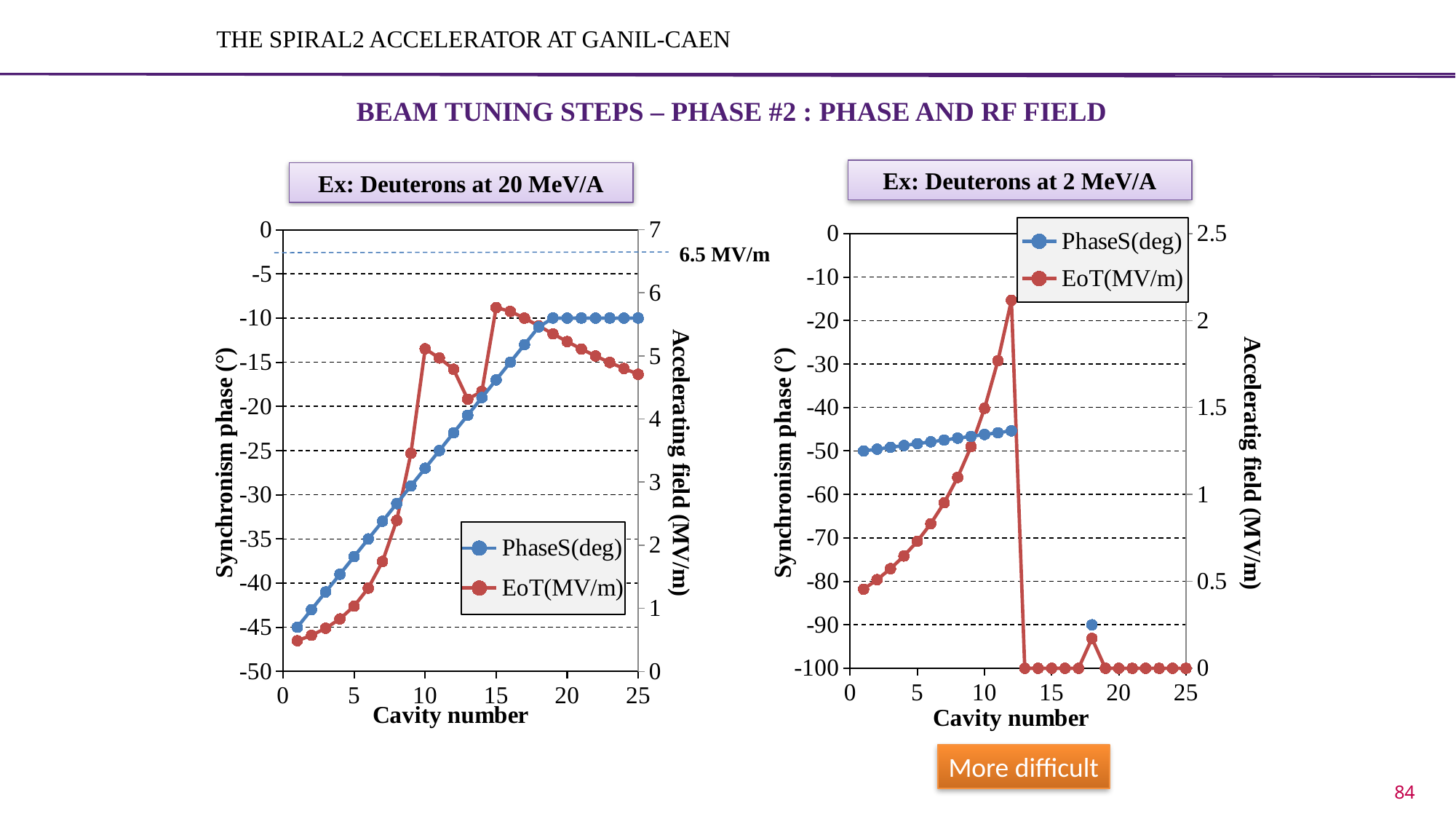
In the 'Ex: Deuterons at 20 MeV/A' chart, what is the value of the dashed reference line labelled on the right axis? 6.5 MV/m In the 'Ex: Deuterons at 2 MeV/A' chart, what is the PhaseS(deg) value at cavity number 18? -90 In the 'Ex: Deuterons at 2 MeV/A' chart, does EoT(MV/m) rise or fall from cavity number 1 to cavity number 12? rise In the 'Ex: Deuterons at 2 MeV/A' chart, at which cavity number is EoT(MV/m) highest? 12 What kind of chart is the 'Ex: Deuterons at 20 MeV/A' chart on the left? line chart In the 'Ex: Deuterons at 20 MeV/A' chart, is the EoT(MV/m) value at cavity number 15 greater or less than 5? greater In the 'Ex: Deuterons at 20 MeV/A' chart, what is the PhaseS(deg) value at cavity number 25? -10 In the 'Ex: Deuterons at 20 MeV/A' chart, what is the PhaseS(deg) value at cavity number 1? -45 In the 'Ex: Deuterons at 20 MeV/A' chart, at which cavity number is EoT(MV/m) highest? 15 In the 'Ex: Deuterons at 2 MeV/A' chart, what is the PhaseS(deg) value at cavity number 1? -50 In the 'Ex: Deuterons at 20 MeV/A' chart, what are the two series named in the legend? PhaseS(deg) and EoT(MV/m) How many series does the legend of the 'Ex: Deuterons at 2 MeV/A' chart list? 2